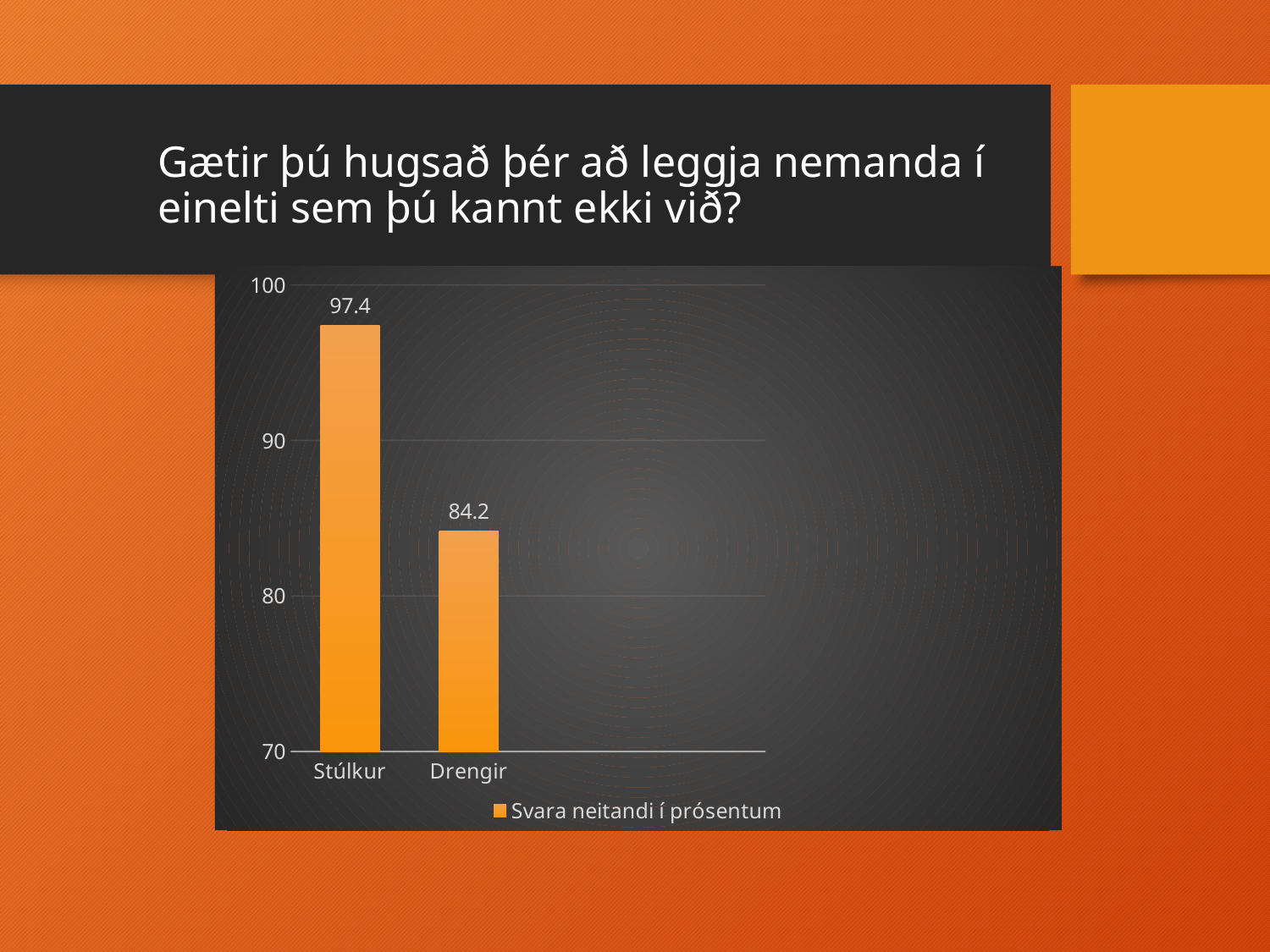
Which category has the highest value? Stúlkur What is the value for Stúlkur? 97.4 What kind of chart is shown on the slide? bar chart Which category has the lowest value? Drengir How many categories are shown on the x axis? 2 What is the name of the series shown in the legend? Svara neitandi í prósentum Which is larger, the value for Stúlkur or the value for Drengir? Stúlkur What is the value for Drengir? 84.2 Is the value for Drengir greater or less than 90? less How many series does the legend list? 1 What is the difference between the values for Stúlkur and Drengir? 13.2 Is the value for Stúlkur greater or less than 90? greater